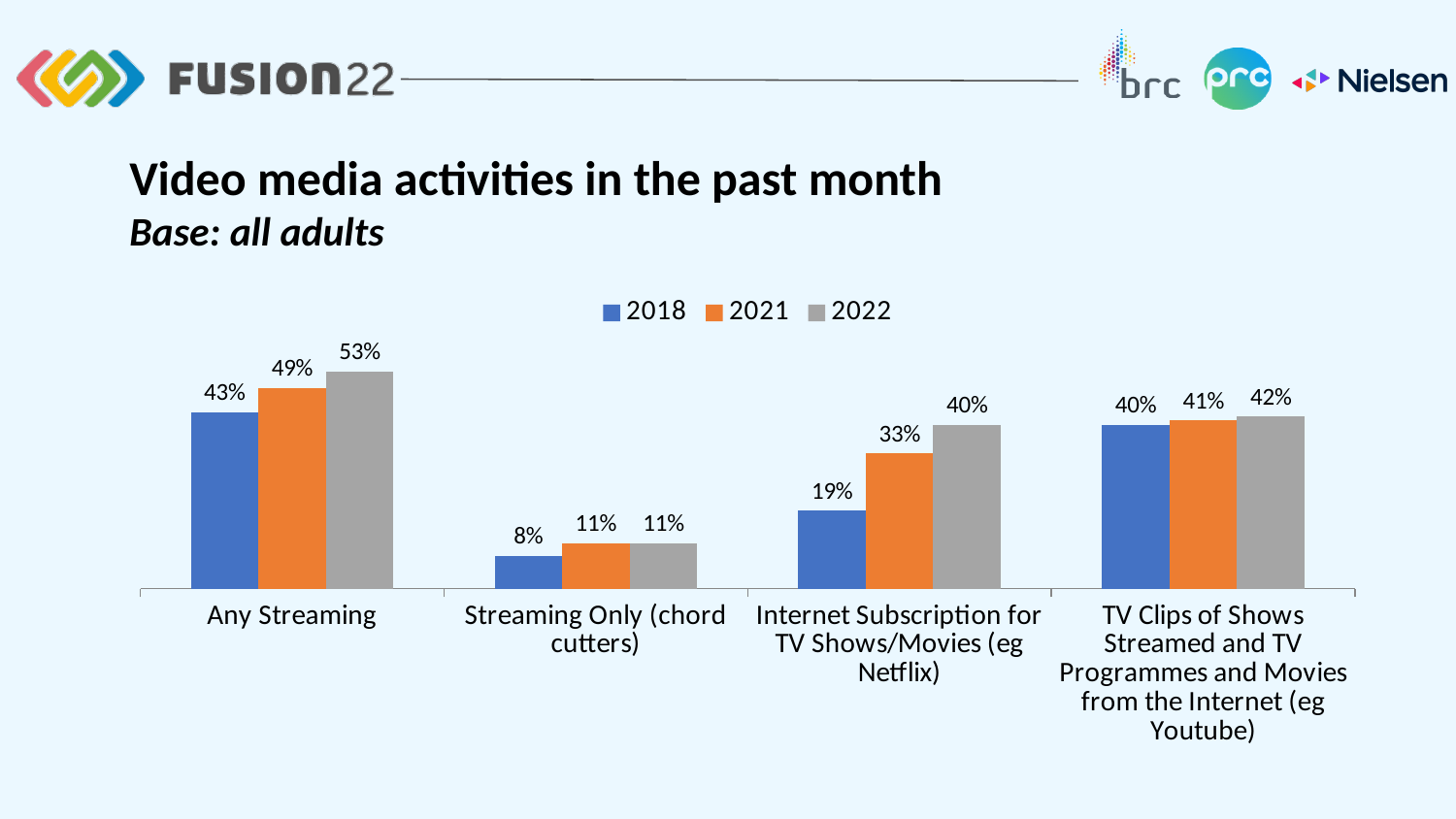
What kind of chart is shown on the slide? Bar chart What is the difference between the 2022 and 2018 values for Internet Subscription for TV Shows/Movies (eg Netflix)? 21 percentage points Which is larger: the 2021 value for Any Streaming or the 2021 value for TV Clips of Shows Streamed and TV Programmes and Movies from the Internet (eg Youtube)? Any Streaming How many series does the legend list? 3 Which category has the lowest 2018 value? Streaming Only (chord cutters) What is the 2022 value for Any Streaming? 53% How many categories are shown on the x axis? 4 What is the title of the chart? Video media activities in the past month What is the 2018 value for Internet Subscription for TV Shows/Movies (eg Netflix)? 19% What is the 2021 value for Streaming Only (chord cutters)? 11% Which category has the highest 2022 value? Any Streaming Do the values for Any Streaming rise or fall from 2018 to 2022? Rise